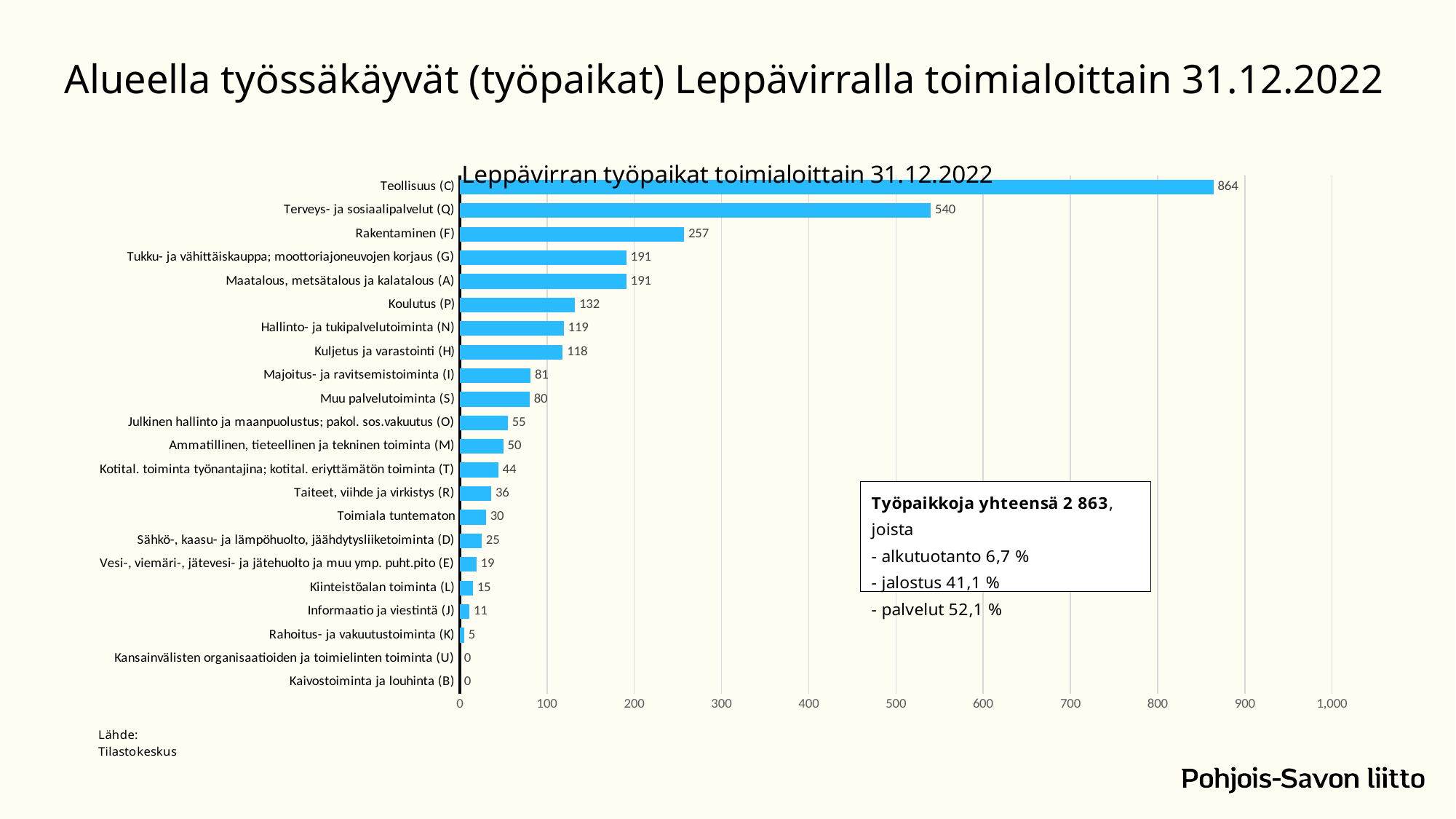
What is the difference between Teollisuus (C) and Terveys- ja sosiaalipalvelut (Q)? 324 Which is larger, Hallinto- ja tukipalvelutoiminta (N) or Majoitus- ja ravitsemistoiminta (I)? Hallinto- ja tukipalvelutoiminta (N) What is the value for Koulutus (P)? 132 What is the difference between Rakentaminen (F) and Koulutus (P)? 125 What is the title of the chart? Leppävirran työpaikat toimialoittain 31.12.2022 Is the value for Terveys- ja sosiaalipalvelut (Q) greater or less than 500? greater What is the total number of jobs stated in the text box on the chart? 2 863 What kind of chart is shown on the slide? bar chart What is the value for Kuljetus ja varastointi (H)? 118 What is the value for Teollisuus (C)? 864 Which category has the highest value? Teollisuus (C) How many categories are shown in the chart? 22